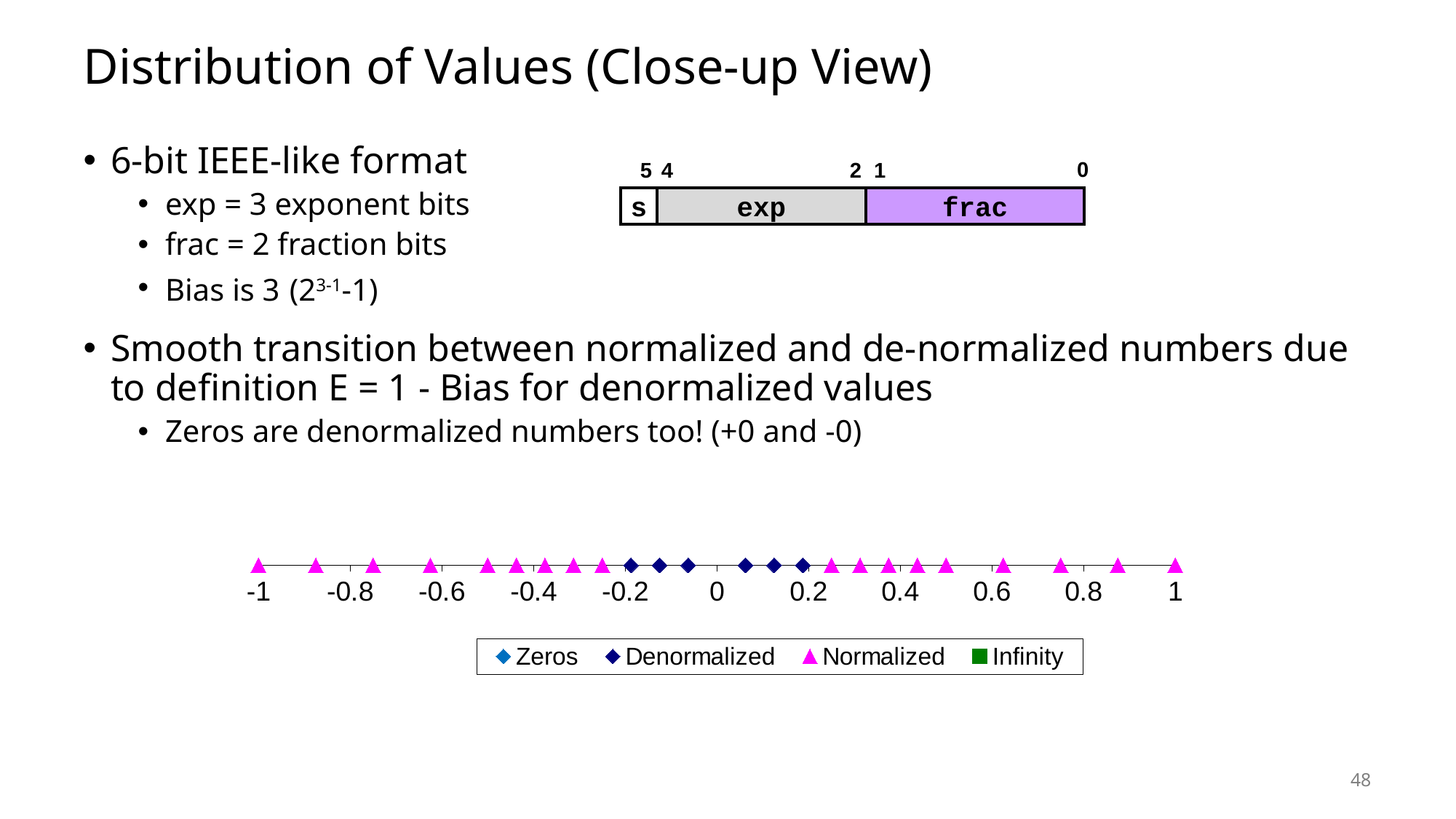
How many Normalized (magenta triangle) points are plotted on the chart? 18 What is the lowest value shown on the x axis of the chart? -1 How many series does the legend of the chart list? 4 What are the four series named in the chart legend? Zeros, Denormalized, Normalized, Infinity What is the highest value shown on the x axis of the chart? 1 Which marker shape and colour is used for the Normalized series in the chart? magenta triangles At what x-axis value does the rightmost Normalized point lie? 1 At what x-axis value does the leftmost Normalized point lie? -1 How many Denormalized (dark blue diamond) points are plotted on the chart? 6 Is the value of the leftmost Denormalized point greater or less than -0.4? greater What kind of chart is shown at the bottom of the slide? scatter chart